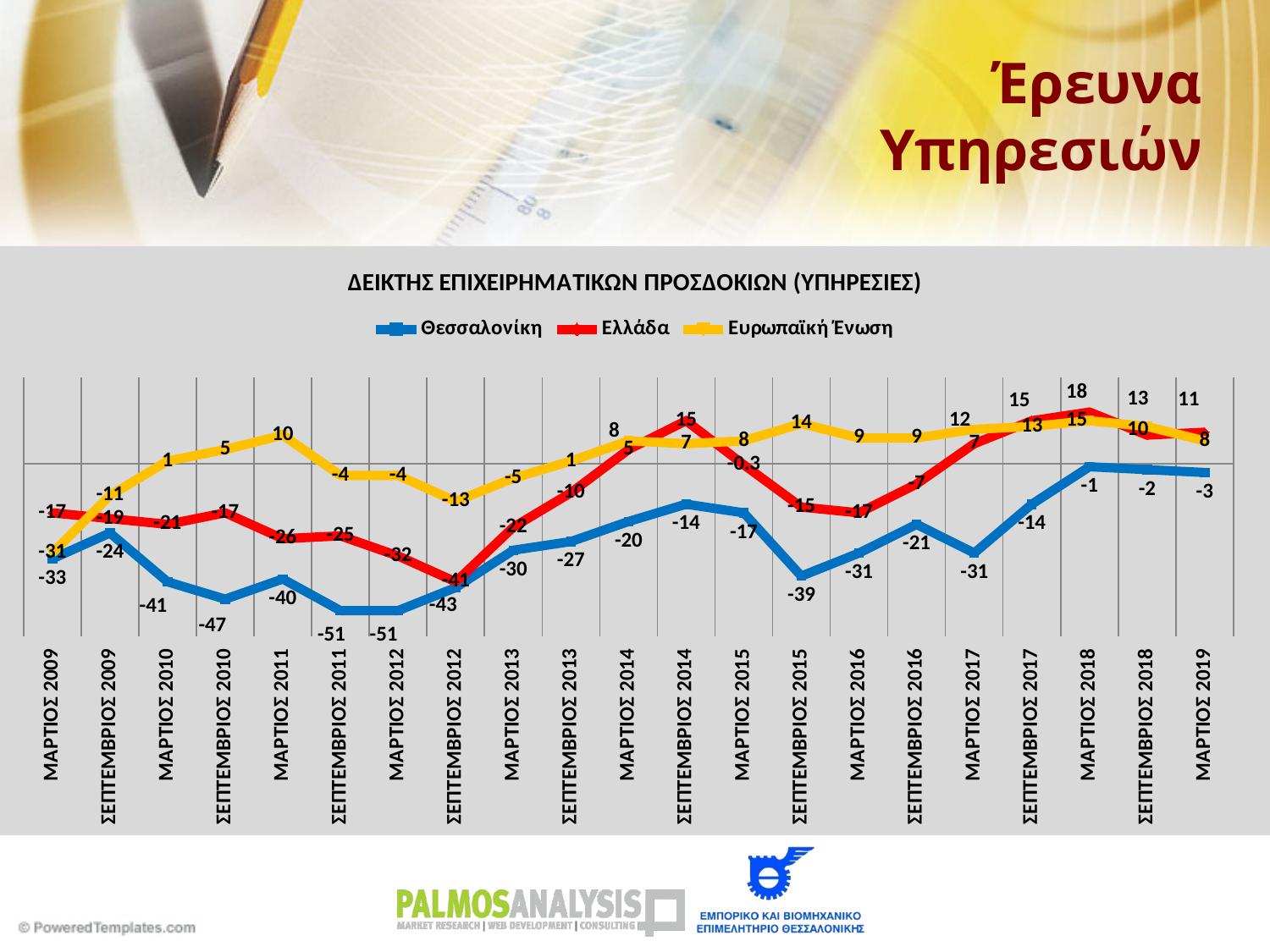
What is the value for Θεσσαλονίκη in ΜΑΡΤΙΟΣ 2019? -3 What is the value for Ελλάδα in ΜΑΡΤΙΟΣ 2015? -0.3 What kind of chart is shown on the slide? line chart What is the value for Ελλάδα in ΣΕΠΤΕΜΒΡΙΟΣ 2014? 15 In which period does Ευρωπαϊκή Ένωση reach its highest value? ΜΑΡΤΙΟΣ 2018 In ΜΑΡΤΙΟΣ 2017, which is higher: Ελλάδα or Θεσσαλονίκη? Ελλάδα In which period does Ελλάδα reach its lowest value? ΣΕΠΤΕΜΒΡΙΟΣ 2012 Does the Θεσσαλονίκη series rise or fall from ΜΑΡΤΙΟΣ 2012 to ΣΕΠΤΕΜΒΡΙΟΣ 2014? rise How many time points are plotted along the x axis? 21 How many series does the legend list? 3 What is the value for Ευρωπαϊκή Ένωση in ΣΕΠΤΕΜΒΡΙΟΣ 2012? -13 By how much did the Θεσσαλονίκη value change between ΜΑΡΤΙΟΣ 2009 and ΜΑΡΤΙΟΣ 2019? 30